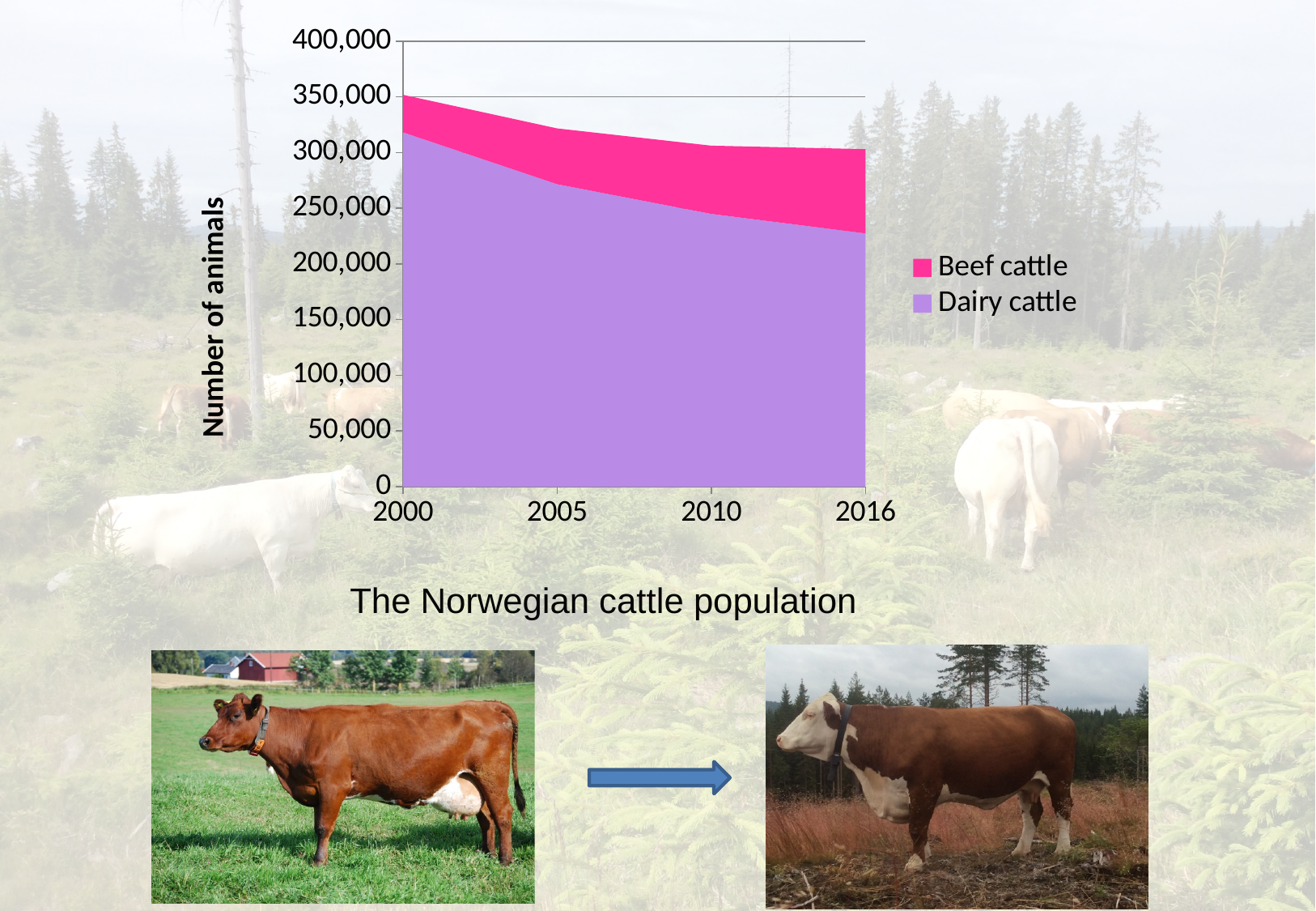
Which two series are listed in the chart's legend? Beef cattle and Dairy cattle What is the label of the chart's vertical axis? Number of animals Is the number of dairy cattle in 2005 greater or less than 250,000? greater How many years are labelled on the chart's x axis? 4 How many series does the chart's legend list? 2 Does the total cattle population rise or fall from 2000 to 2016? Fall Is the number of dairy cattle in 2016 greater or less than 250,000? less What kind of chart is shown on the slide? Area chart In which year shown is the number of dairy cattle highest? 2000 Which series has the larger number of animals in 2016, Beef cattle or Dairy cattle? Dairy cattle Does the number of dairy cattle rise or fall from 2000 to 2016? Fall Is the number of dairy cattle in 2000 greater or less than 300,000? greater